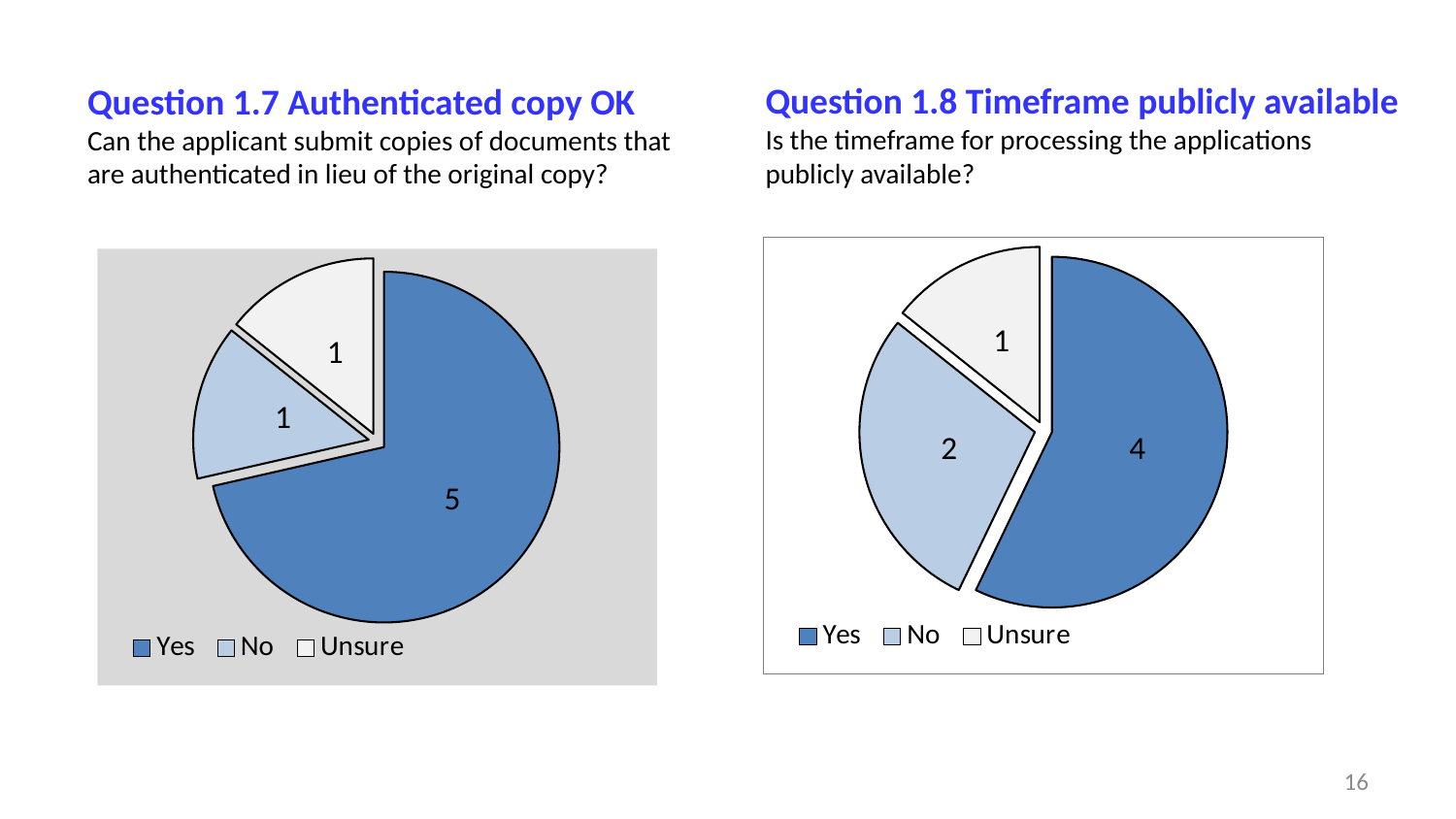
In the Question 1.8 Timeframe publicly available chart, what share of the total does the No slice represent? 2 out of 7 What are the legend entries in the Question 1.7 Authenticated copy OK chart? Yes, No, Unsure In the Question 1.8 Timeframe publicly available chart, which is larger, Yes or No? Yes In the Question 1.7 Authenticated copy OK chart, what is the value for Yes? 5 In the Question 1.8 Timeframe publicly available chart, what is the value for Yes? 4 In the Question 1.7 Authenticated copy OK chart, what is the difference between the Yes and Unsure values? 4 What kind of chart is the Question 1.8 Timeframe publicly available chart? Pie chart In the Question 1.8 Timeframe publicly available chart, what is the value for No? 2 In the Question 1.8 Timeframe publicly available chart, which category has the smallest slice? Unsure In the Question 1.7 Authenticated copy OK chart, which category has the largest slice? Yes How many categories does the Question 1.7 Authenticated copy OK chart show? 3 In the Question 1.8 Timeframe publicly available chart, what is the difference between the Yes and No values? 2